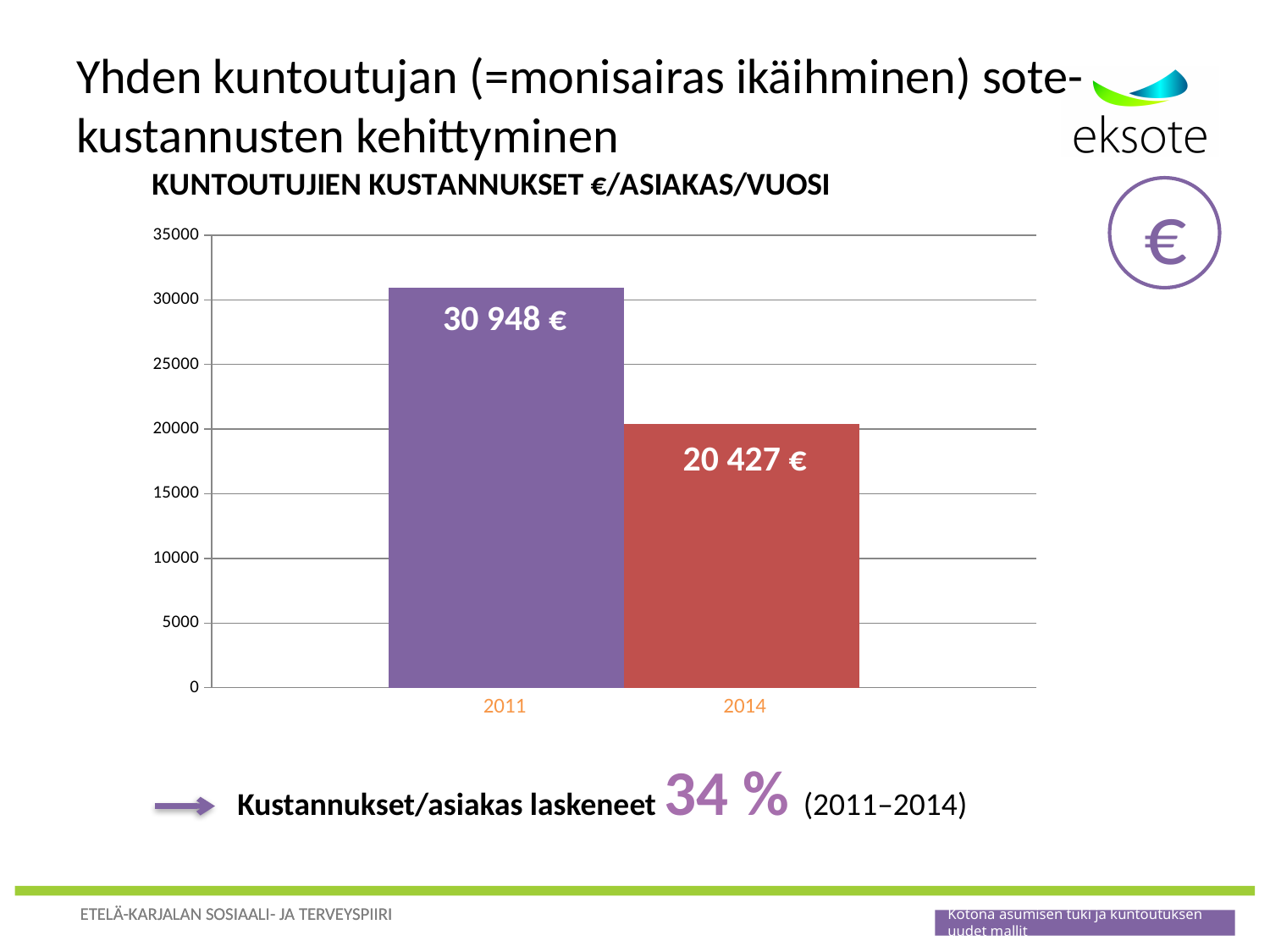
Is the value for 2011 greater or less than 30000? greater What kind of chart is shown on the slide? bar chart What is the value for 2014? 20 427 € Is the value for 2014 greater or less than 25000? less Which is larger, the value for 2011 or the value for 2014? 2011 How many years are shown on the x axis? 2 What is the value for 2011? 30 948 € Which year has the highest cost per customer? 2011 Which year has the lowest cost per customer? 2014 What is the difference between the 2011 and 2014 values? 10 521 € Do the values rise or fall from 2011 to 2014? fall What is the title of the chart? KUNTOUTUJIEN KUSTANNUKSET €/ASIAKAS/VUOSI